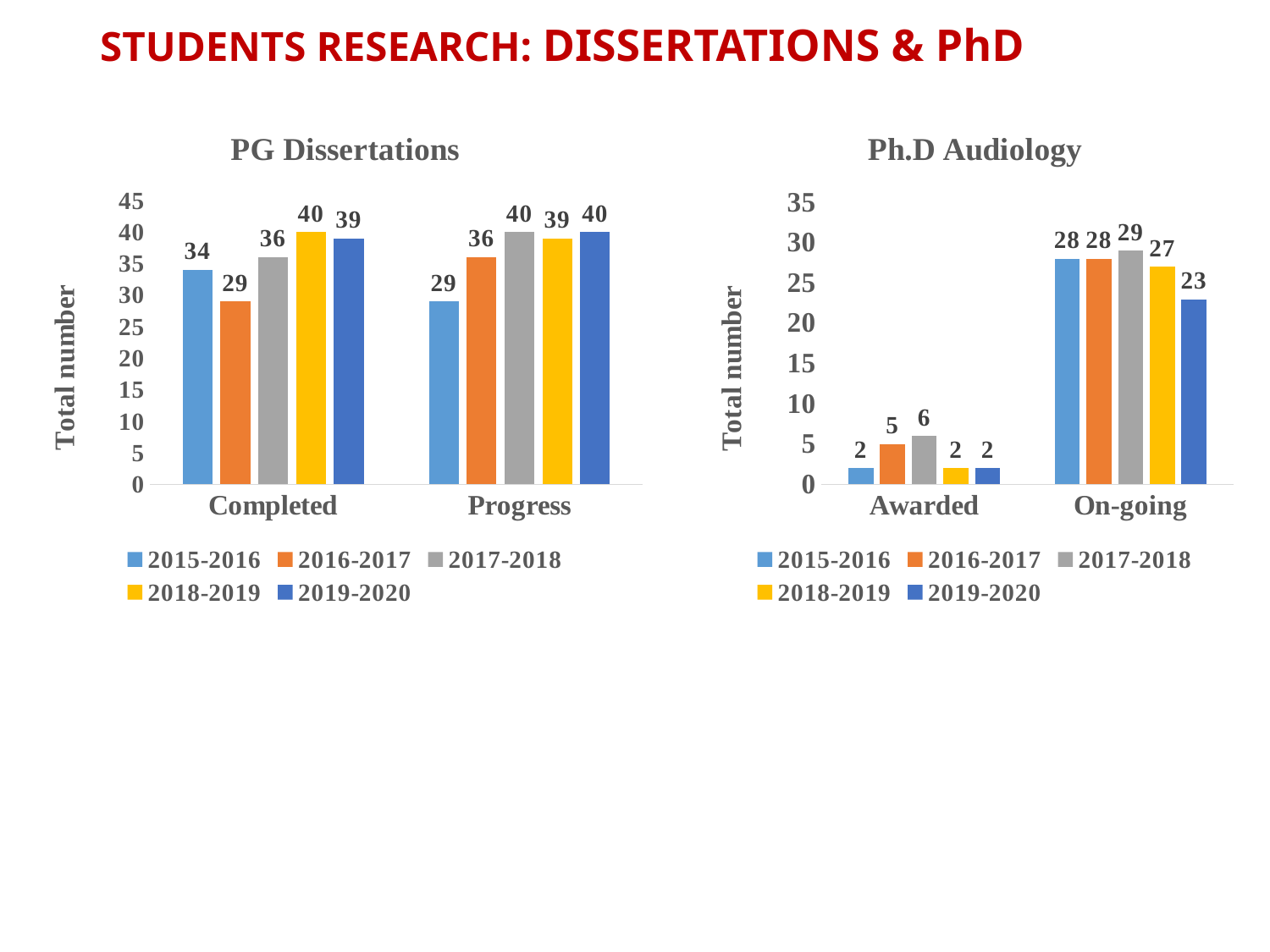
In the PG Dissertations chart, what is the value for 2015-2016 in the Completed category? 34 In the PG Dissertations chart, which series has the lowest value in the Completed category? 2016-2017 In the Ph.D Audiology chart, which series has the highest value in the On-going category? 2017-2018 In the Ph.D Audiology chart, how many categories are shown on the x axis? 2 In the Ph.D Audiology chart, what is the difference between the 2017-2018 and 2019-2020 values in the On-going category? 6 In the PG Dissertations chart, what is the value for 2016-2017 in the Progress category? 36 What kind of chart is the Ph.D Audiology chart? Bar chart In the PG Dissertations chart, how many series does the legend list? 5 In the PG Dissertations chart, what is the difference between the 2018-2019 and 2016-2017 values in the Completed category? 11 In the Ph.D Audiology chart, what is the value for 2019-2020 in the On-going category? 23 In the Ph.D Audiology chart, what is the value for 2017-2018 in the Awarded category? 6 In the Ph.D Audiology chart, which is larger in the Awarded category: 2016-2017 or 2018-2019? 2016-2017